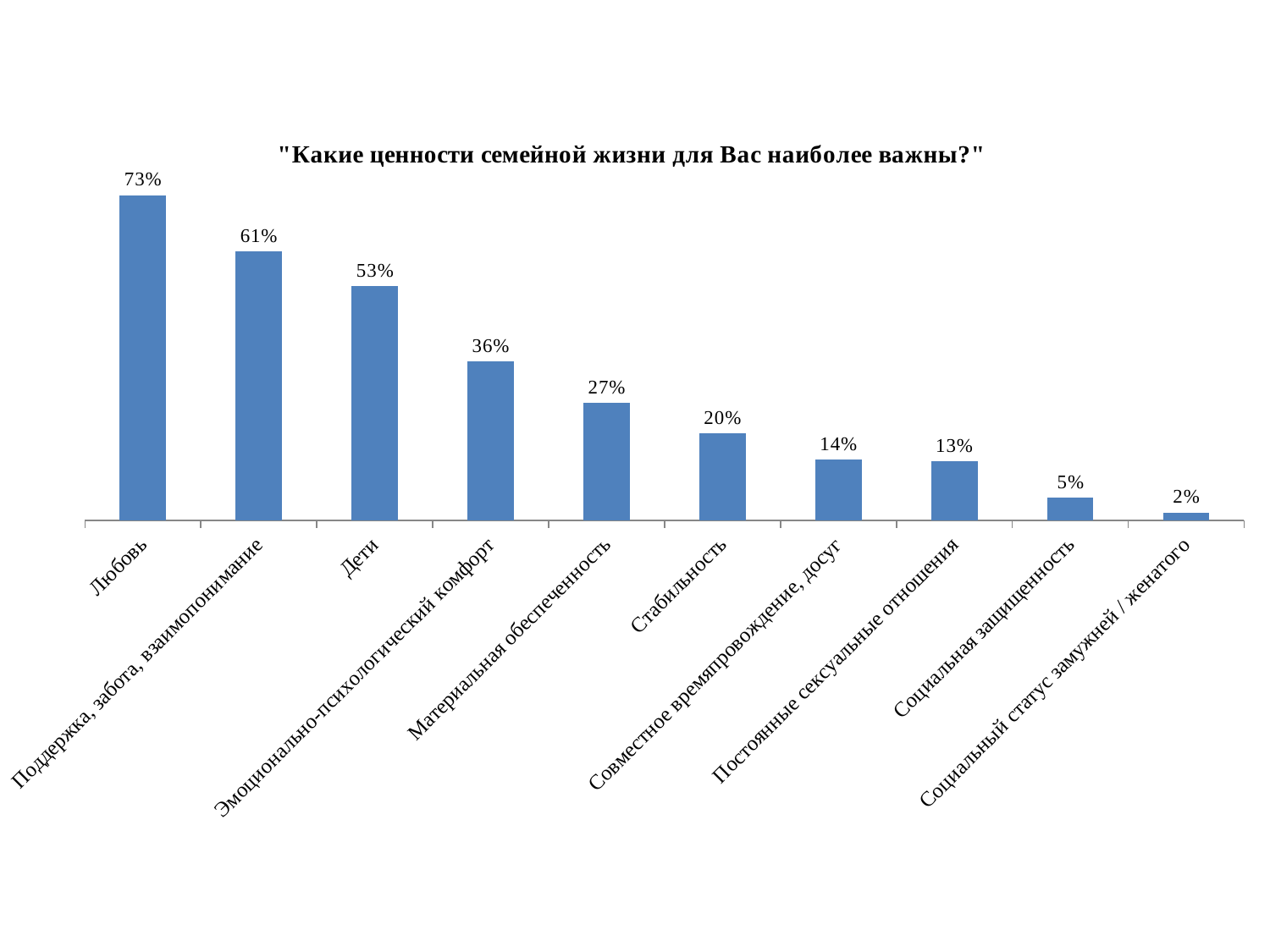
How many categories are shown in the chart? 10 What is the difference between the values for Любовь and Поддержка, забота, взаимопонимание? 12% What is the value for Стабильность? 20% Which category has the highest value? Любовь Do the values rise or fall from left to right along the x axis? Fall Which is larger, the value for Совместное времяпровождение, досуг or the value for Постоянные сексуальные отношения? Совместное времяпровождение, досуг What is the value for Социальная защищенность? 5% What is the difference between the values for Эмоционально-психологический комфорт and Материальная обеспеченность? 9% What is the value for Любовь? 73% What kind of chart is this? Bar chart Which category has the lowest value? Социальный статус замужней / женатого What is the value for Дети? 53%